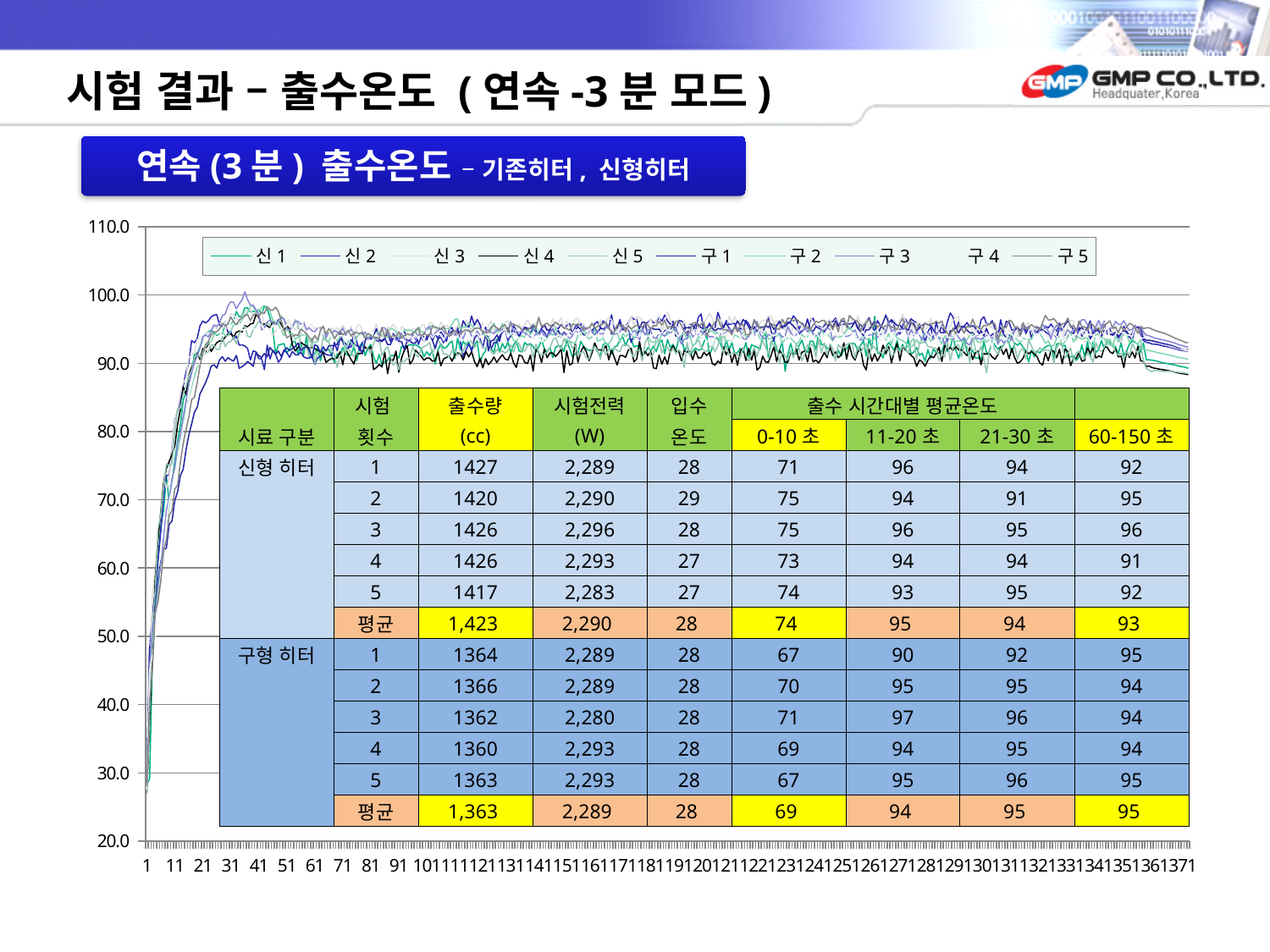
What is the first series listed in the chart legend? 신 1 Is the highest point reached by any line greater or less than 110? less What kind of chart is shown on the slide? line chart What is the highest tick value shown on the y axis? 110.0 How many series does the chart legend list? 10 Is the value of the lines at x = 371 greater or less than 80? greater What is the last series listed in the chart legend? 구 5 Is the value of the lines at x = 1 greater or less than 40? less Do the lines rise or fall between x = 1 and x = 31? rise